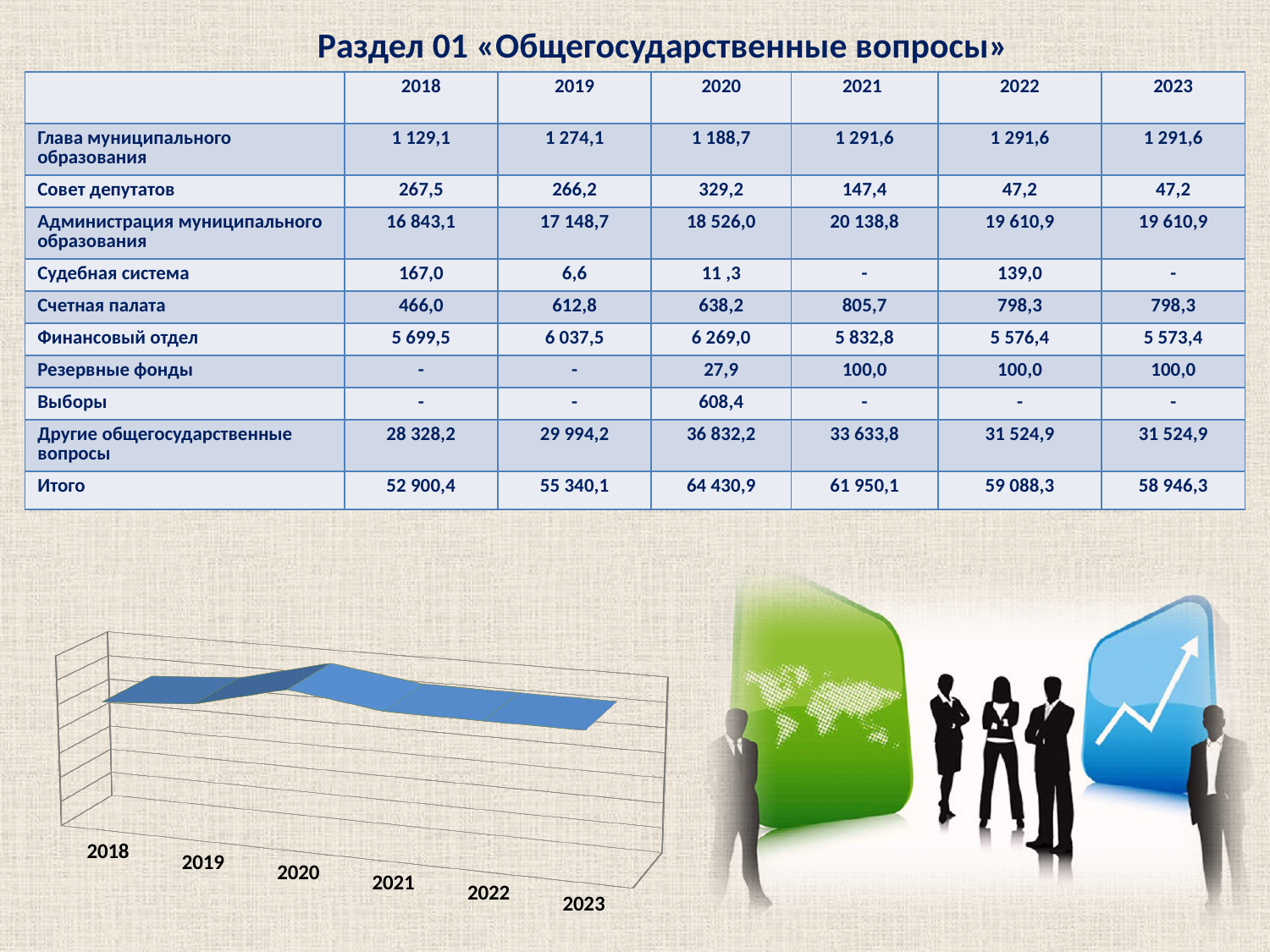
Which year has the highest value in the chart? 2020 In the chart, which is larger, the value for 2020 or the value for 2023? 2020 What is the first year shown on the x axis of the chart? 2018 How many data series are plotted in the chart? 1 Does the plotted value rise or fall from 2020 to 2023 in the chart? fall In the chart, which is larger, the value for 2020 or the value for 2021? 2020 How many years are shown on the x axis of the chart? 6 What is the last year shown on the x axis of the chart? 2023 What kind of chart is shown at the bottom left of the slide? 3D line chart Does the plotted value rise or fall from 2018 to 2020 in the chart? rise